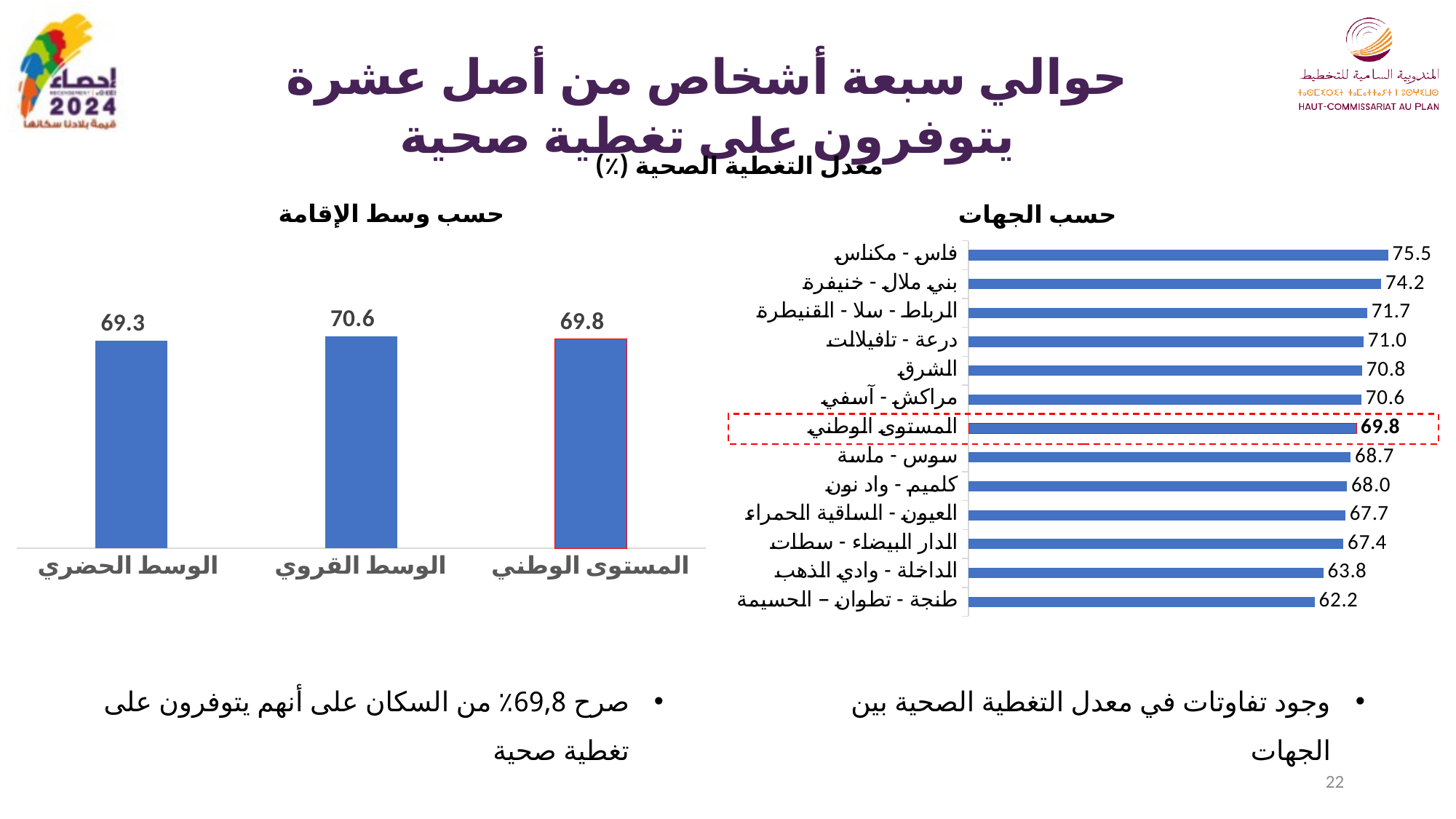
In the chart titled 'حسب الجهات', which category has the highest value? فاس - مكناس In the chart titled 'حسب الجهات', what is the difference between فاس - مكناس and طنجة - تطوان – الحسيمة? 13.3 In the chart titled 'حسب الجهات', what is the value for الداخلة - وادي الذهب? 63.8 In the chart titled 'حسب الجهات', which category is highlighted with a red dashed box? المستوى الوطني In the chart titled 'حسب وسط الإقامة', which is larger: الوسط الحضري or المستوى الوطني? المستوى الوطني What type of chart is the one titled 'حسب الجهات'? Bar chart In the chart titled 'حسب وسط الإقامة', what is the difference between الوسط القروي and الوسط الحضري? 1.3 In the chart titled 'حسب الجهات', how many bars are plotted? 13 In the chart titled 'حسب وسط الإقامة', which category has the lowest value? الوسط الحضري In the chart titled 'حسب الجهات', which region has the lowest value? طنجة - تطوان – الحسيمة In the chart titled 'حسب الجهات', what is the value for فاس - مكناس? 75.5 In the chart titled 'حسب وسط الإقامة', what is the value for الوسط القروي? 70.6